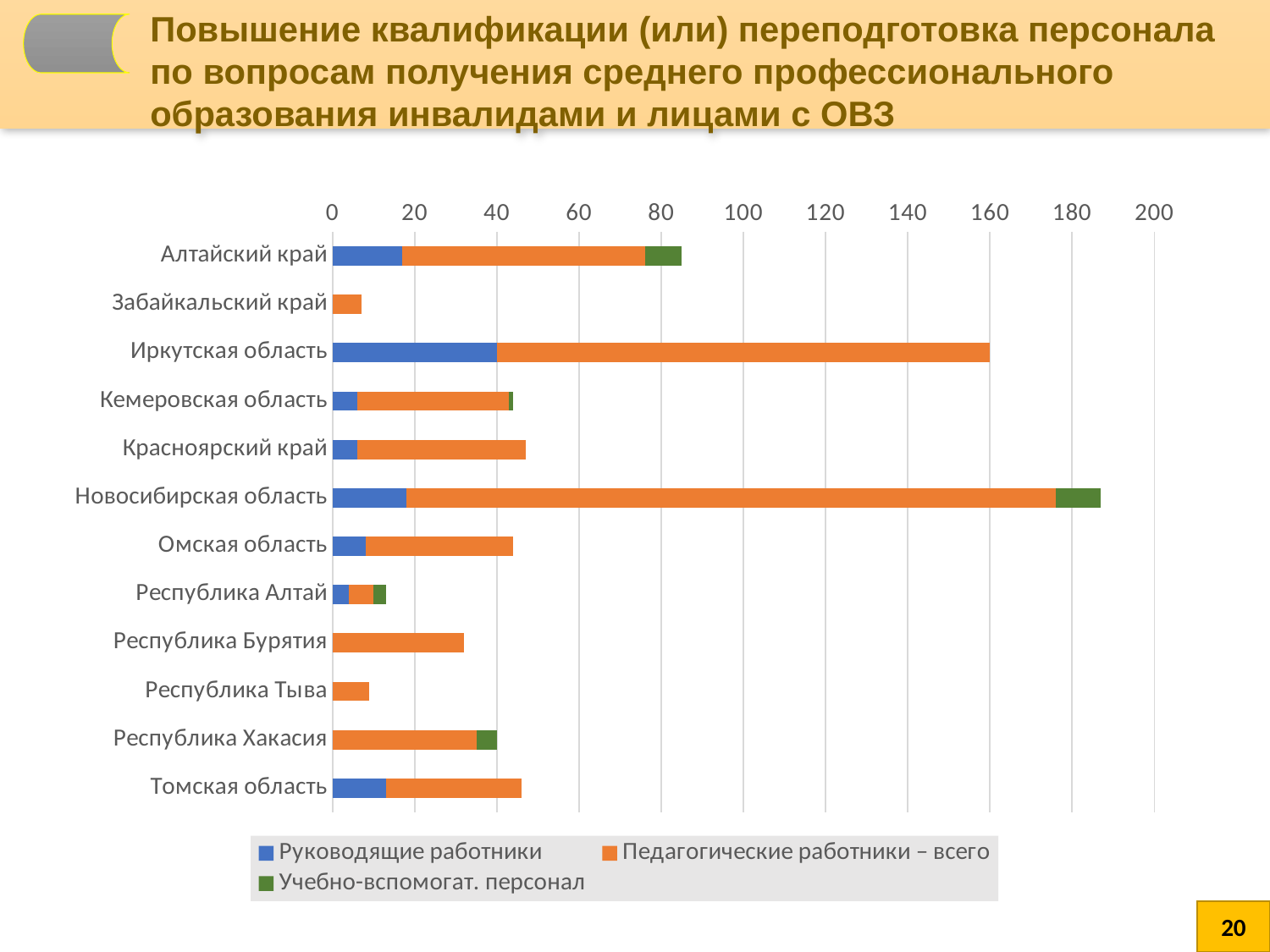
Is the total bar for Алтайский край greater or less than 60? greater What kind of chart is shown on the slide? bar chart How many regions (categories) are listed on the chart? 12 Is the total bar for Иркутская область greater or less than 140? greater Which series is shown in orange in the legend? Педагогические работники – всего How many series does the legend list? 3 Which has the longer total bar, Томская область or Республика Алтай? Томская область Which has the longer total bar, Иркутская область or Омская область? Иркутская область Is the total bar for Республика Бурятия greater or less than 40? less Which series is shown in green in the legend? Учебно-вспомогат. персонал Which region has the longest total bar? Новосибирская область